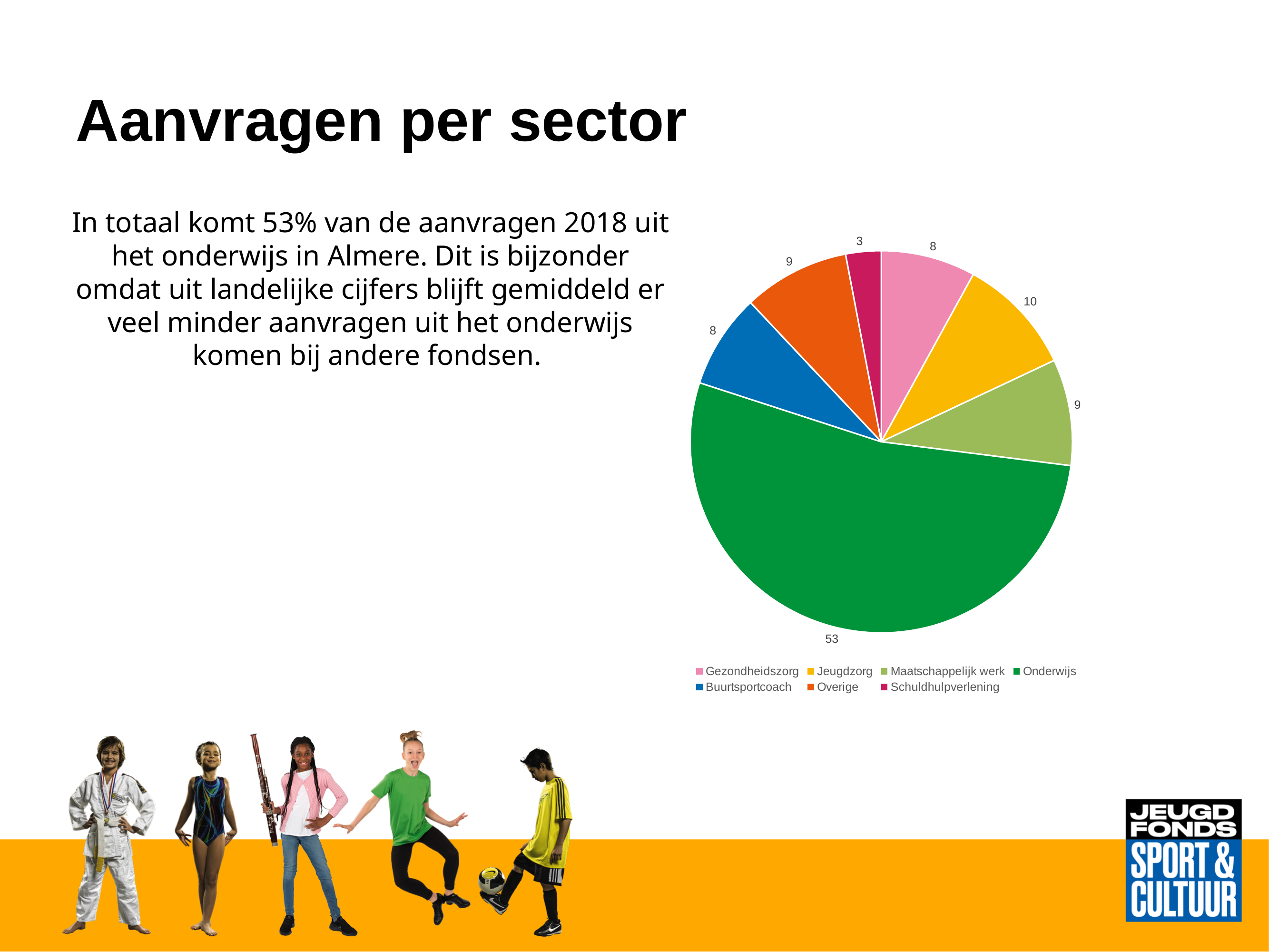
What kind of chart is shown on the slide? Pie chart What value is shown for the Buurtsportcoach slice? 8 Which sector has the smallest slice of the pie chart? Schuldhulpverlening How many sectors (slices) does the pie chart show? 7 Which sector has the largest slice of the pie chart? Onderwijs What is the difference between the values for Jeugdzorg and Schuldhulpverlening? 7 Which is larger, the value for Jeugdzorg or the value for Gezondheidszorg? Jeugdzorg What value is shown for the Schuldhulpverlening slice? 3 What share of the pie does the Onderwijs slice represent? 53% What colour is the Onderwijs slice in the pie chart? Green What value is shown for the Onderwijs slice of the pie chart? 53 What value is shown for the Jeugdzorg slice? 10